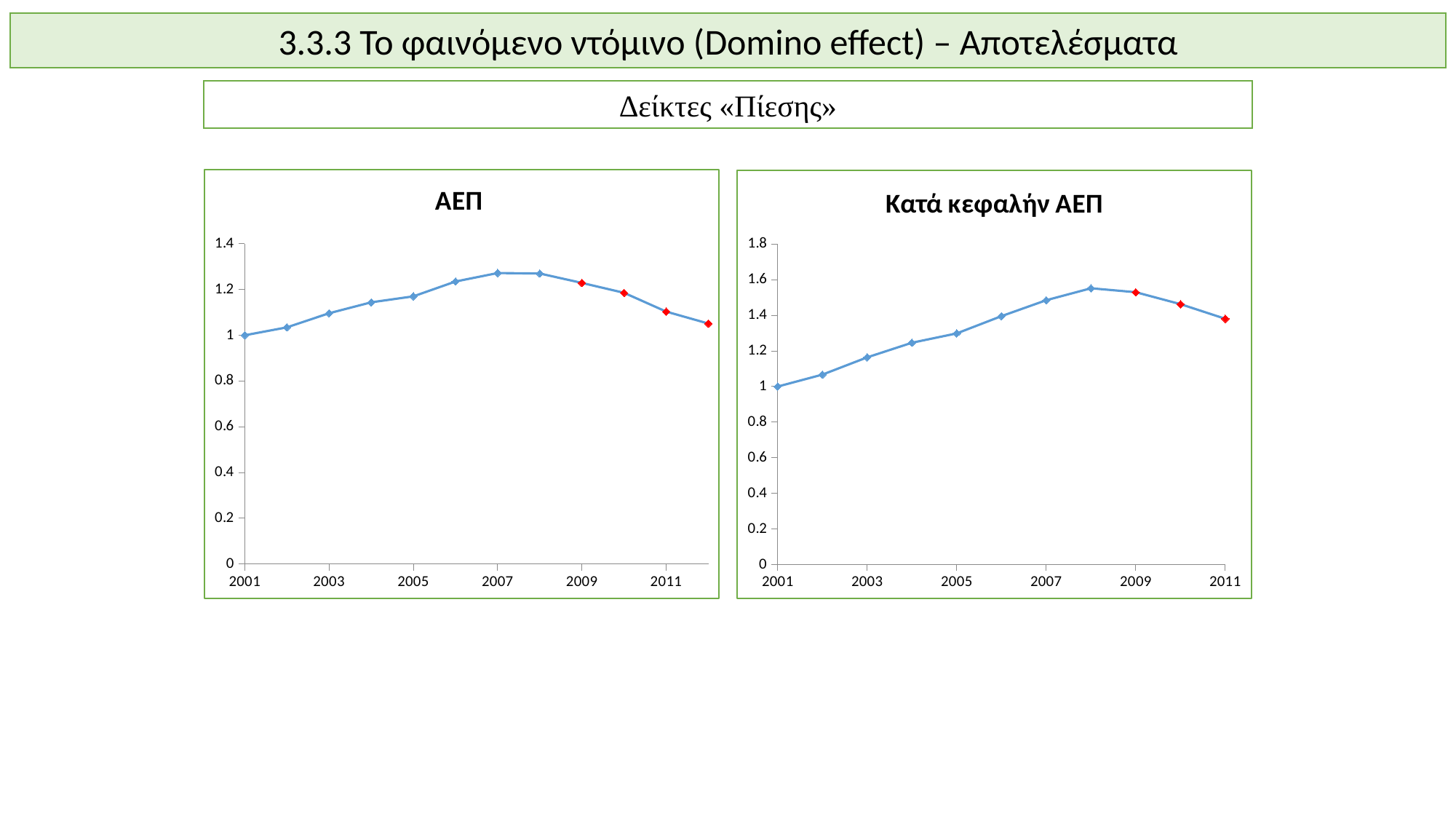
In the ΑΕΠ chart on the left, which is larger, the value for 2007 or the value for 2003? 2007 What type of chart is the ΑΕΠ chart on the left? Line chart How many data points are plotted in the Κατά κεφαλήν ΑΕΠ chart on the right? 11 In the ΑΕΠ chart on the left, is the value for 2003 greater or less than 1.2? less In the Κατά κεφαλήν ΑΕΠ chart on the right, what is the value for 2001? 1 In the ΑΕΠ chart on the left, which year has the lowest value? 2001 In the ΑΕΠ chart on the left, what is the value for 2001? 1 In the ΑΕΠ chart on the left, is the value for 2007 greater or less than 1.2? greater In the Κατά κεφαλήν ΑΕΠ chart on the right, is the value for 2008 greater or less than 1.4? greater In the Κατά κεφαλήν ΑΕΠ chart on the right, which year has the lowest value? 2001 In the ΑΕΠ chart on the left, how do the values change from 2001 to 2012? They rise until around 2007–2008, then fall